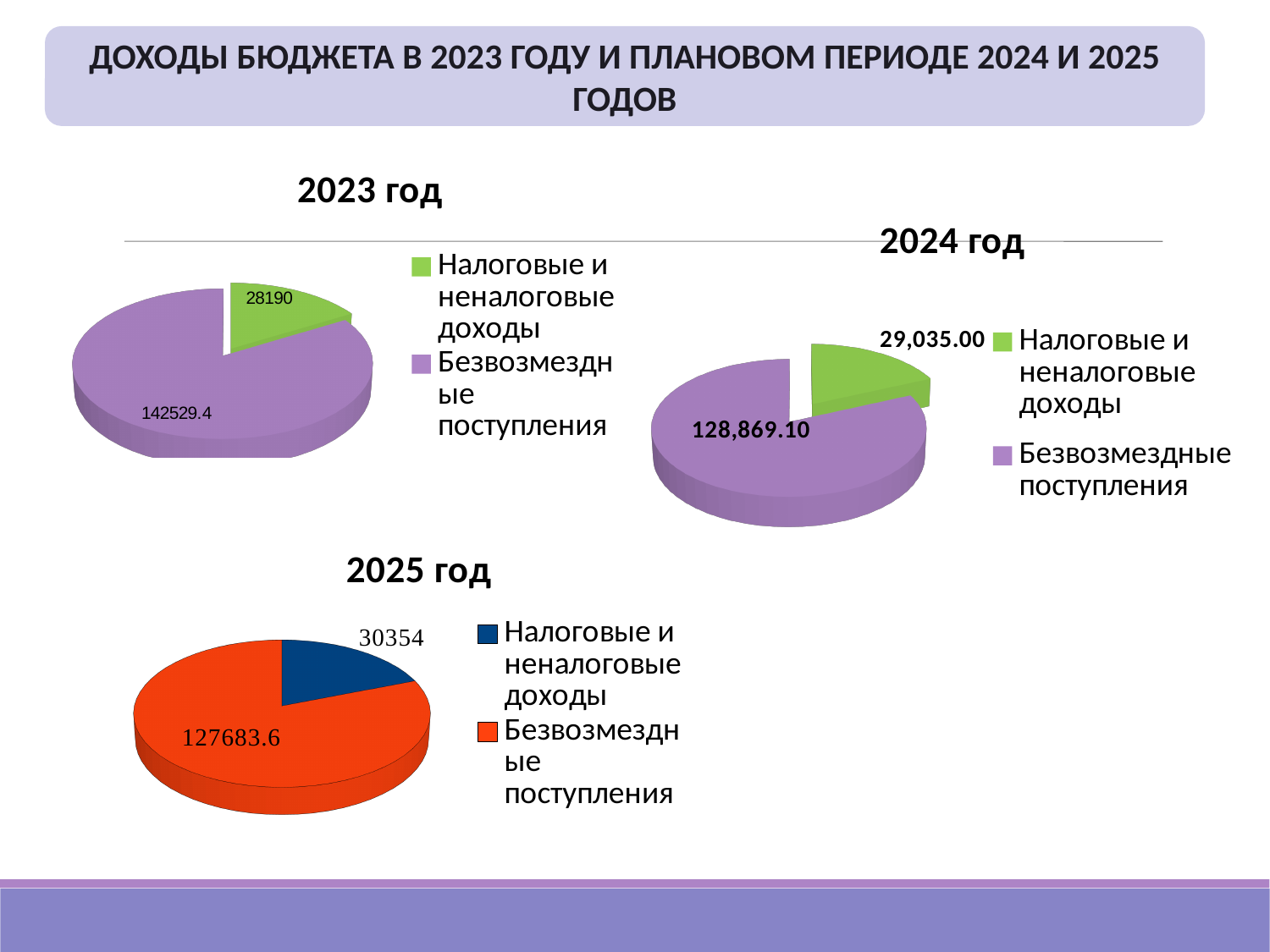
What kind of chart is the "2024 год" chart? Pie chart In the "2025 год" chart, what is the value for Налоговые и неналоговые доходы? 30354 How many slices does the "2025 год" chart have? 2 In the "2023 год" chart, which is larger: Налоговые и неналоговые доходы or Безвозмездные поступления? Безвозмездные поступления In the "2023 год" chart, what is the value for Безвозмездные поступления? 142529.4 In the "2024 год" chart, which category has the smallest slice? Налоговые и неналоговые доходы In the "2024 год" chart, what is the value for Безвозмездные поступления? 128,869.10 In the "2025 год" chart, which category has the largest slice? Безвозмездные поступления In the "2024 год" chart, what is the value for Налоговые и неналоговые доходы? 29,035.00 In the "2025 год" chart, what is the total of the two slices? 158037.6 In the "2023 год" chart, what is the difference between Безвозмездные поступления and Налоговые и неналоговые доходы? 114339.4 In the "2023 год" chart, what is the value for Налоговые и неналоговые доходы? 28190